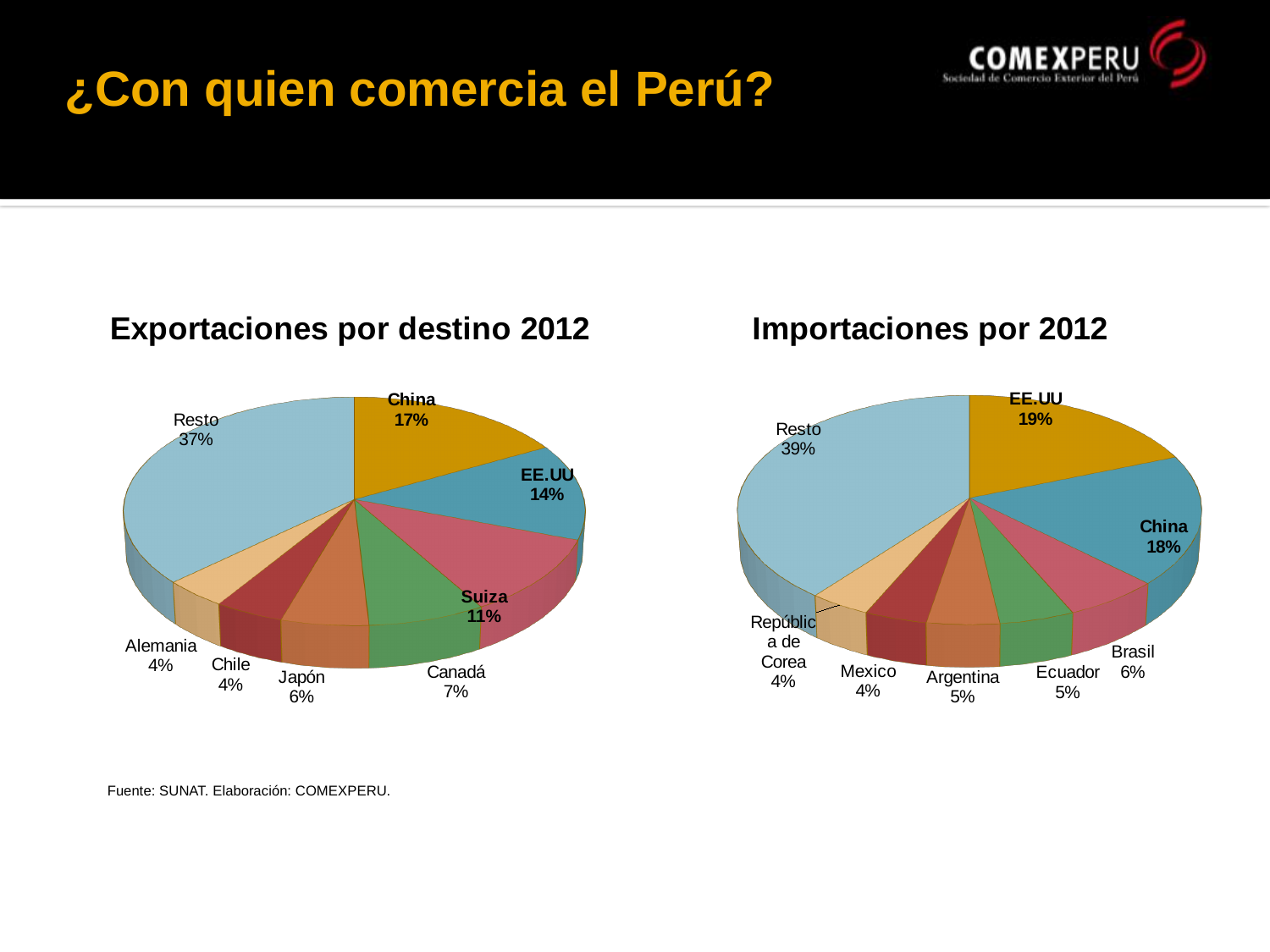
In the 'Importaciones por 2012' chart, which named country (excluding Resto) has the largest share? EE.UU In the 'Importaciones por 2012' chart, what is the share for Brasil? 6% In the 'Exportaciones por destino 2012' chart, what share does China have? 17% In the 'Importaciones por 2012' chart, what is the difference between the shares of Resto and EE.UU? 20% What type of chart is 'Exportaciones por destino 2012'? Pie chart In the 'Exportaciones por destino 2012' chart, what is the share for Suiza? 11% In the 'Exportaciones por destino 2012' chart, which named country (excluding Resto) has the largest share? China In the 'Exportaciones por destino 2012' chart, which is larger, the share of Canadá or the share of Japón? Canadá What is the title of the chart on the right side of the slide? Importaciones por 2012 How many slices does the 'Importaciones por 2012' pie chart have? 8 In the 'Importaciones por 2012' chart, what share does EE.UU have? 19% In the 'Exportaciones por destino 2012' chart, what is the difference between the shares of China and EE.UU? 3%